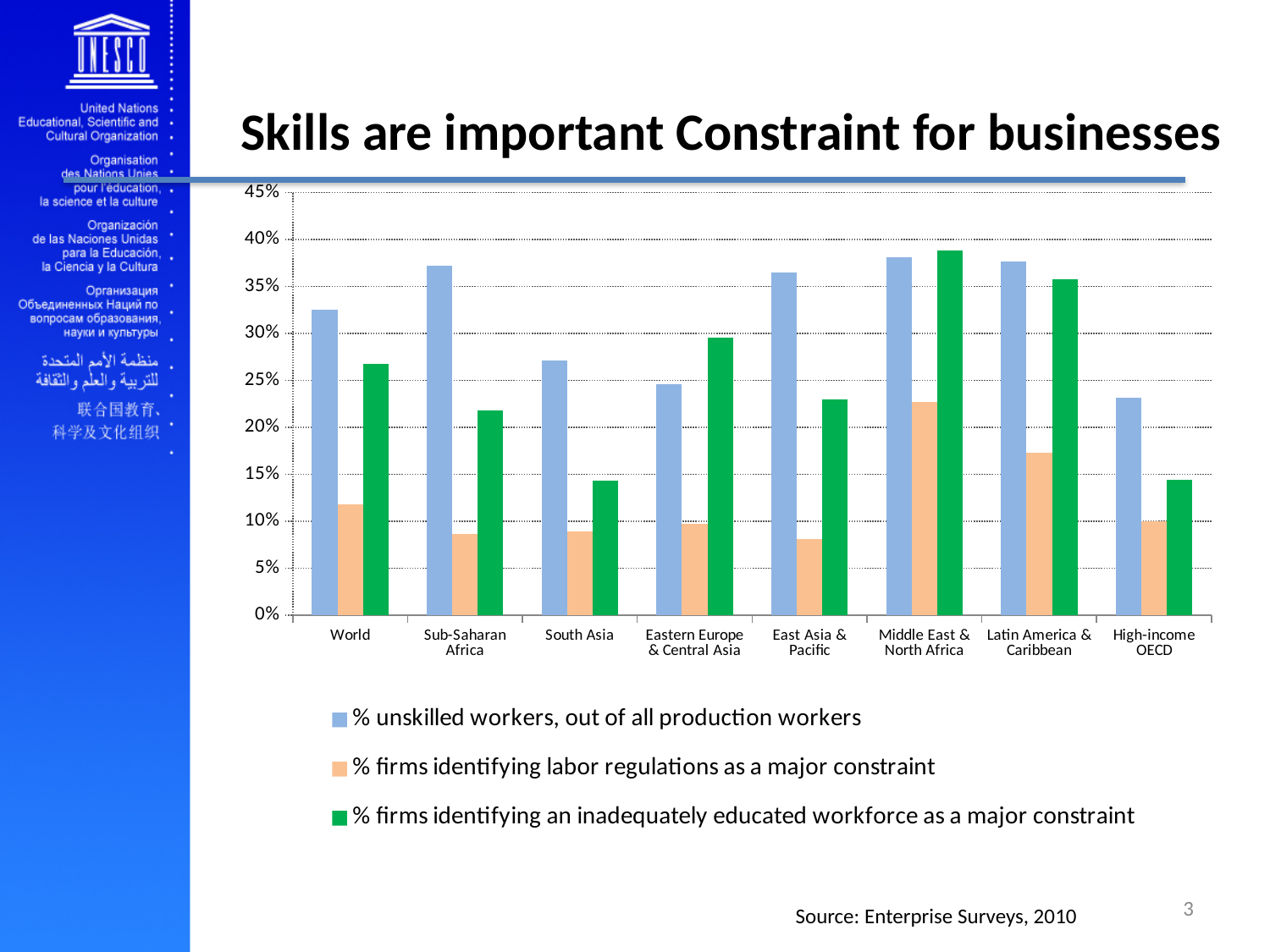
Is the value for '% firms identifying labor regulations as a major constraint' for Middle East & North Africa greater or less than 20%? greater What kind of chart is shown on the slide? bar chart Is the value for '% firms identifying an inadequately educated workforce as a major constraint' for Eastern Europe & Central Asia greater or less than 25%? greater How many series does the chart's legend list? 3 For Sub-Saharan Africa, which is larger: '% unskilled workers, out of all production workers' or '% firms identifying an inadequately educated workforce as a major constraint'? % unskilled workers, out of all production workers Which region has the highest value for '% firms identifying labor regulations as a major constraint'? Middle East & North Africa What is the title of the slide containing the chart? Skills are important Constraint for businesses How many regions (categories) are shown on the x axis of the chart? 8 Is the value for '% unskilled workers, out of all production workers' for World greater or less than 30%? greater For Eastern Europe & Central Asia, which is larger: '% unskilled workers, out of all production workers' or '% firms identifying an inadequately educated workforce as a major constraint'? % firms identifying an inadequately educated workforce as a major constraint Which region has the highest value for '% firms identifying an inadequately educated workforce as a major constraint'? Middle East & North Africa